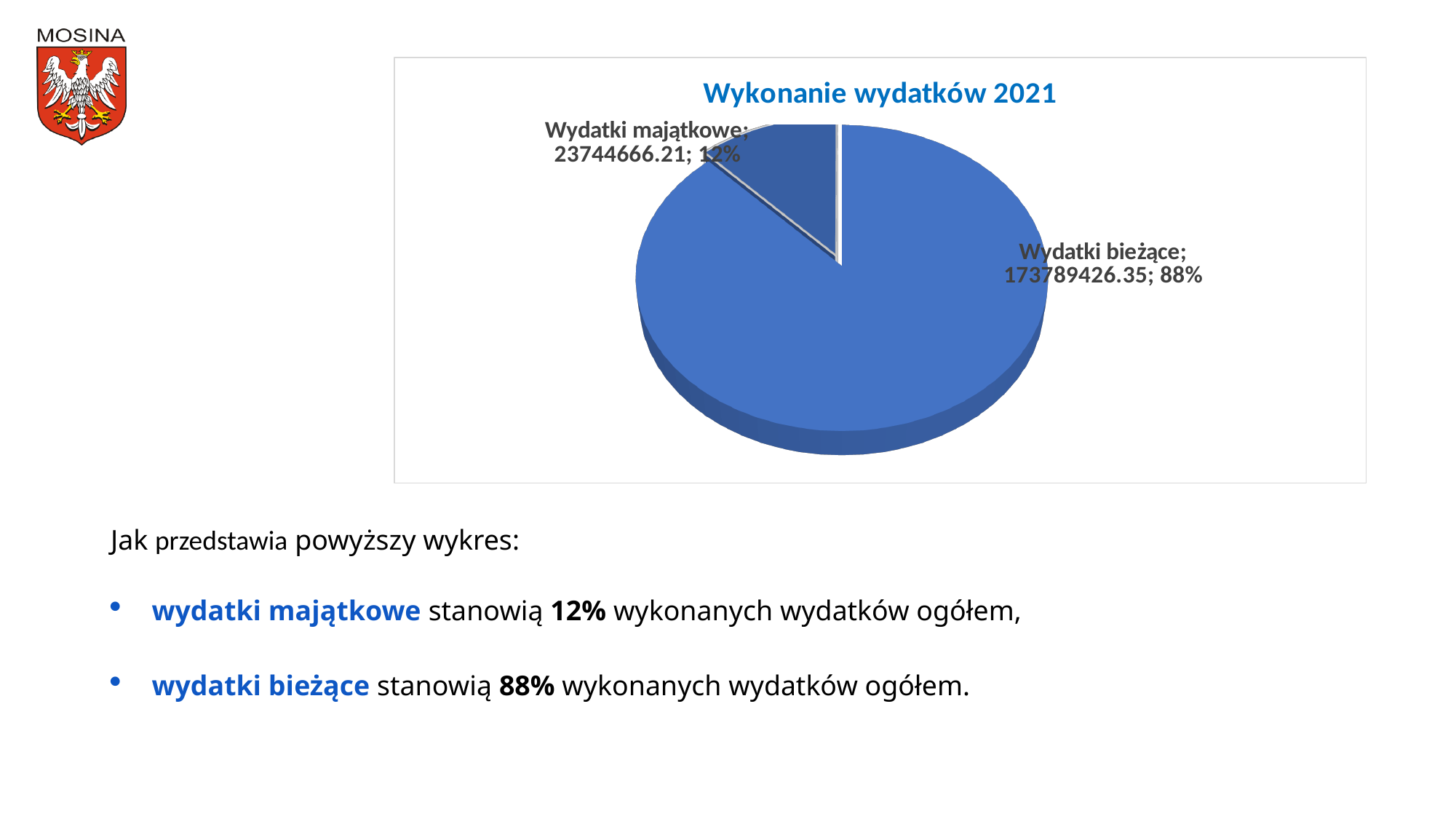
Which category has the smallest slice of the pie? Wydatki majątkowe Which is larger, Wydatki bieżące or Wydatki majątkowe? Wydatki bieżące What is the difference between the values for Wydatki bieżące and Wydatki majątkowe? 150044760.14 What is the total of the two values shown in the pie chart? 197534092.56 What type of chart is shown on the slide? pie chart What is the value shown for Wydatki bieżące? 173789426.35 What is the title of the chart? Wykonanie wydatków 2021 What share of the pie does Wydatki bieżące represent? 88% How many slices does the pie chart have? 2 What is the value shown for Wydatki majątkowe? 23744666.21 Which category has the largest slice of the pie? Wydatki bieżące What share of the pie does Wydatki majątkowe represent? 12%